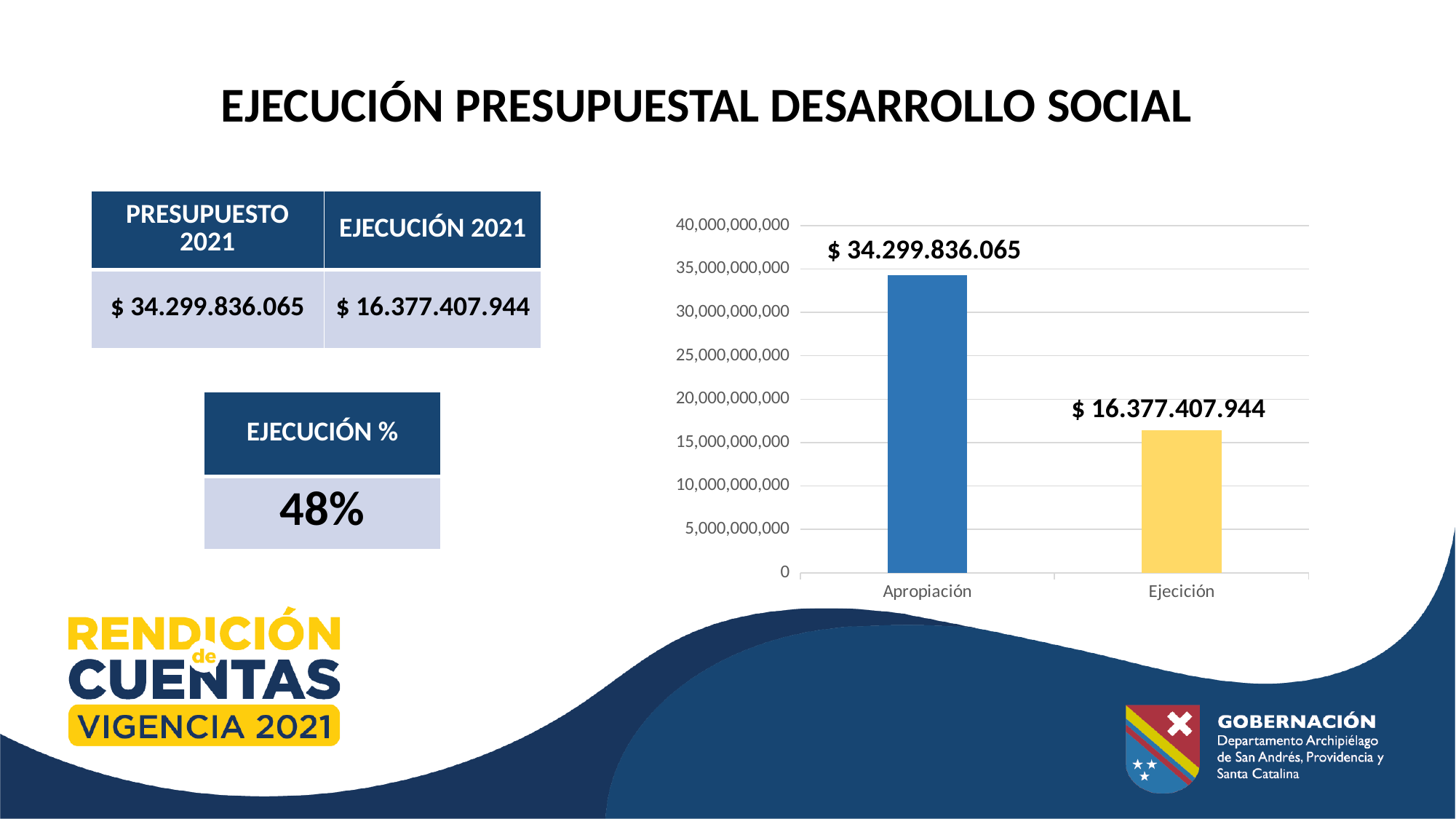
Which is larger, the Apropiación value or the Ejecición value? Apropiación Which category has the highest value in the chart? Apropiación What is the value of the Ejecición bar? $ 16.377.407.944 What is the highest value shown on the chart's vertical axis? 40,000,000,000 Which category has the lowest value in the chart? Ejecición How many categories are shown on the x axis of the chart? 2 Is the value for Apropiación greater or less than 30,000,000,000? greater What colour is the Ejecición bar? Yellow What kind of chart is shown on the slide? Bar chart Is the value for Ejecición greater or less than 20,000,000,000? less What is the difference between the Apropiación and Ejecición values? $ 17.922.428.121 What is the value of the Apropiación bar? $ 34.299.836.065